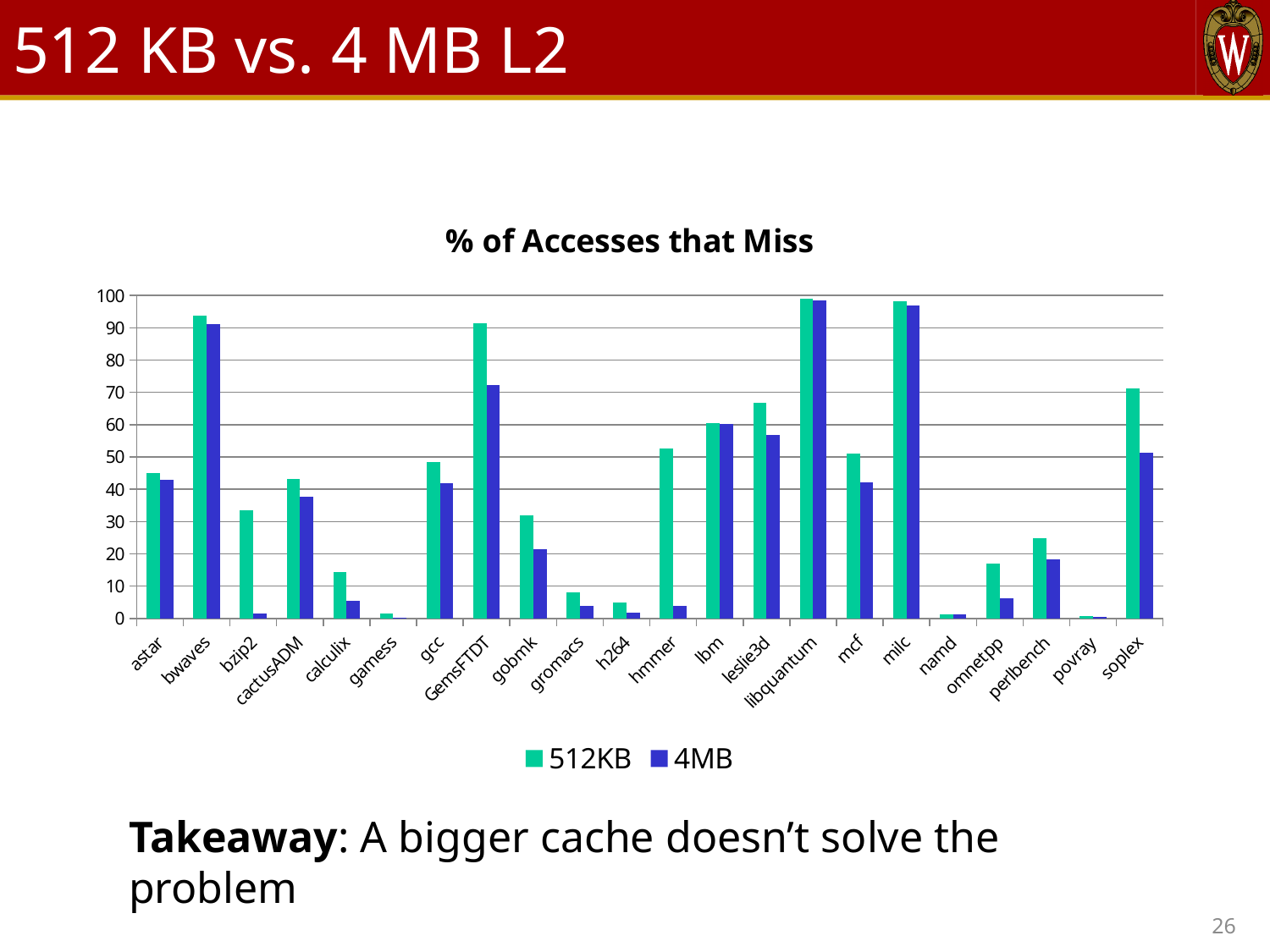
How many benchmark categories are shown on the x axis? 22 What kind of chart is shown on the slide? bar chart How many series does the legend list? 2 For bzip2, which series has the larger value, 512KB or 4MB? 512KB Is the 4MB value for mcf greater or less than 50? less Is the 4MB value for hmmer greater or less than 10? less What is the title of the chart? % of Accesses that Miss Is the 4MB value for GemsFTDT greater or less than 70? greater For hmmer, which series has the larger value, 512KB or 4MB? 512KB Which has the larger 512KB value, bwaves or astar? bwaves